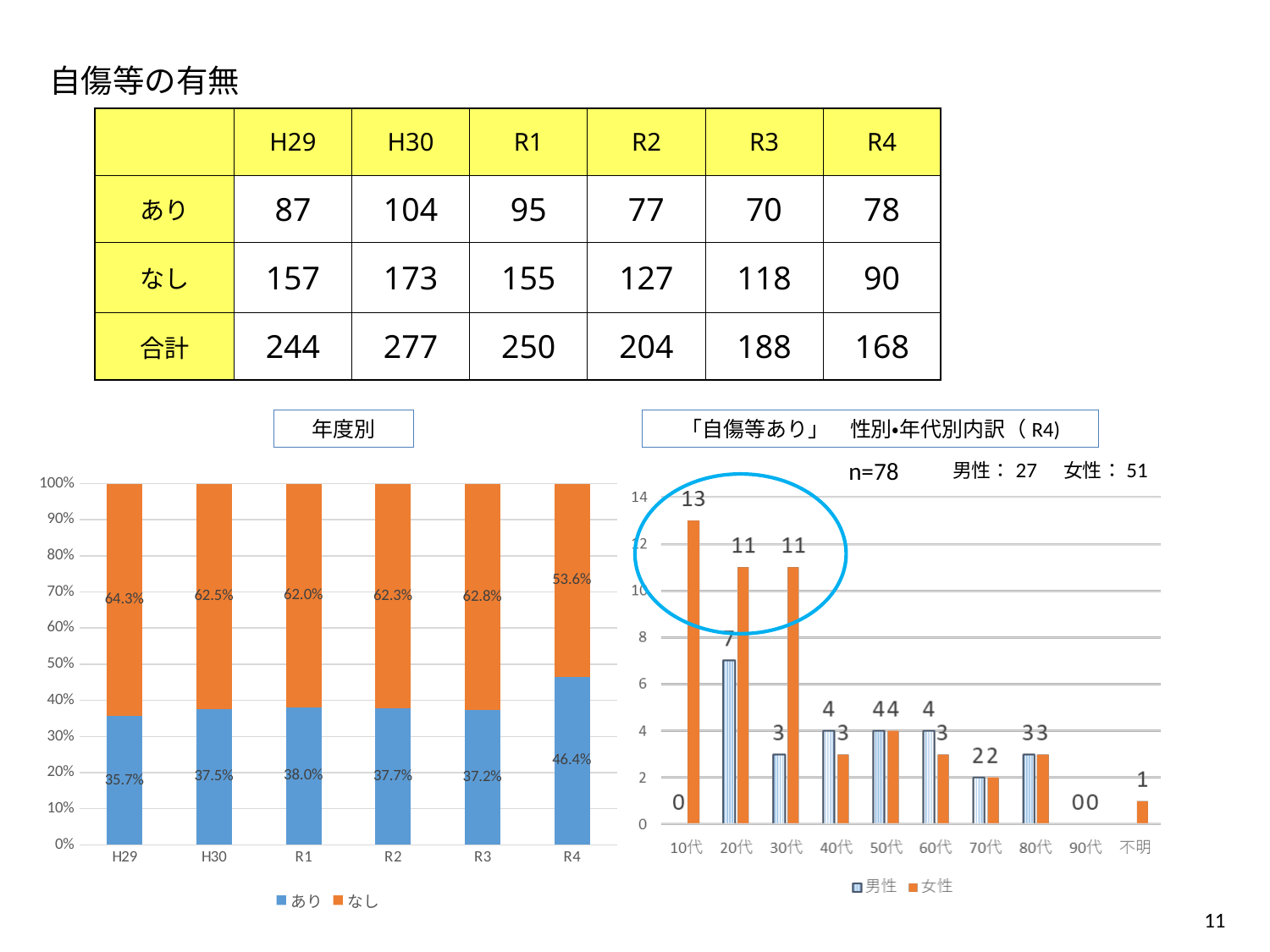
In the 「自傷等あり」 性別•年代別内訳（R4） chart, how many age categories are shown on the x axis? 10 In the 年度別 chart, how many series does the legend list? 2 In the 「自傷等あり」 性別•年代別内訳（R4） chart, which age group has the highest 女性 value? 10代 In the 「自傷等あり」 性別•年代別内訳（R4） chart, what is the value of 男性 for 20代? 7 In the 「自傷等あり」 性別•年代別内訳（R4） chart, what is the value of 女性 for 10代? 13 In the 「自傷等あり」 性別•年代別内訳（R4） chart, is the 女性 value for 30代 larger or smaller than the 男性 value for 30代? larger In the 年度別 chart, which year has the lowest あり share? H29 In the 年度別 chart, what is the difference between the あり share for R4 and the あり share for R3? 9.2% In the 年度別 chart, what is the value of なし for H29? 64.3% In the 年度別 chart, which year has the highest あり share? R4 In the 年度別 chart, what is the value of あり for R4? 46.4% What kind of chart is the 年度別 chart? Stacked bar chart